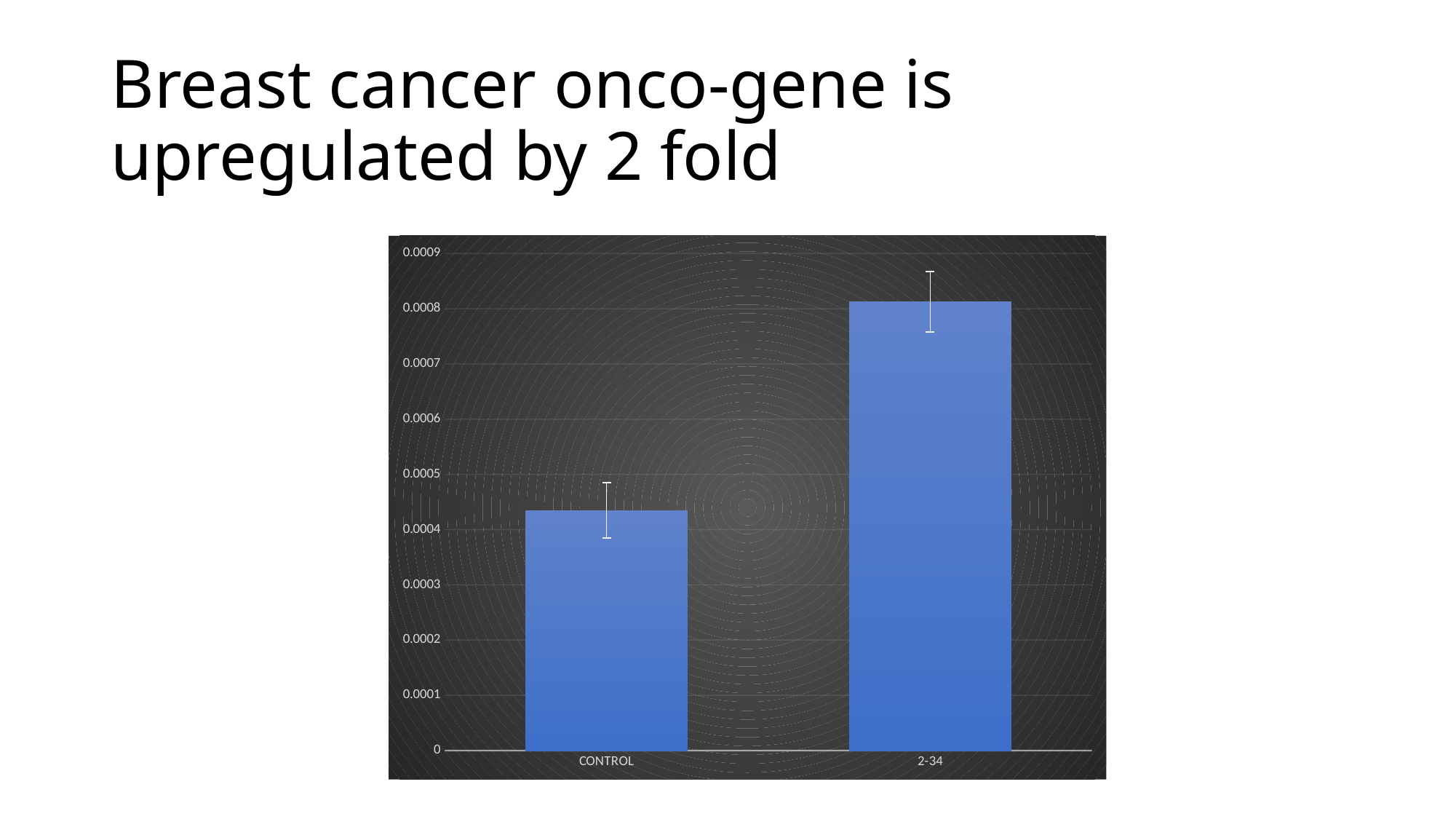
How many categories are plotted on the x axis? 2 Which category has the lowest value? CONTROL Is the value for CONTROL greater or less than 0.0004? greater Which is larger, the value for CONTROL or the value for 2-34? 2-34 What is the label of the second bar on the x axis? 2-34 What kind of chart is shown on the slide? bar chart Which category has the highest value? 2-34 Do the values rise or fall from CONTROL to 2-34? rise What is the highest tick value shown on the y axis? 0.0009 Is the value for 2-34 greater or less than 0.0009? less Is the value for CONTROL greater or less than 0.0005? less